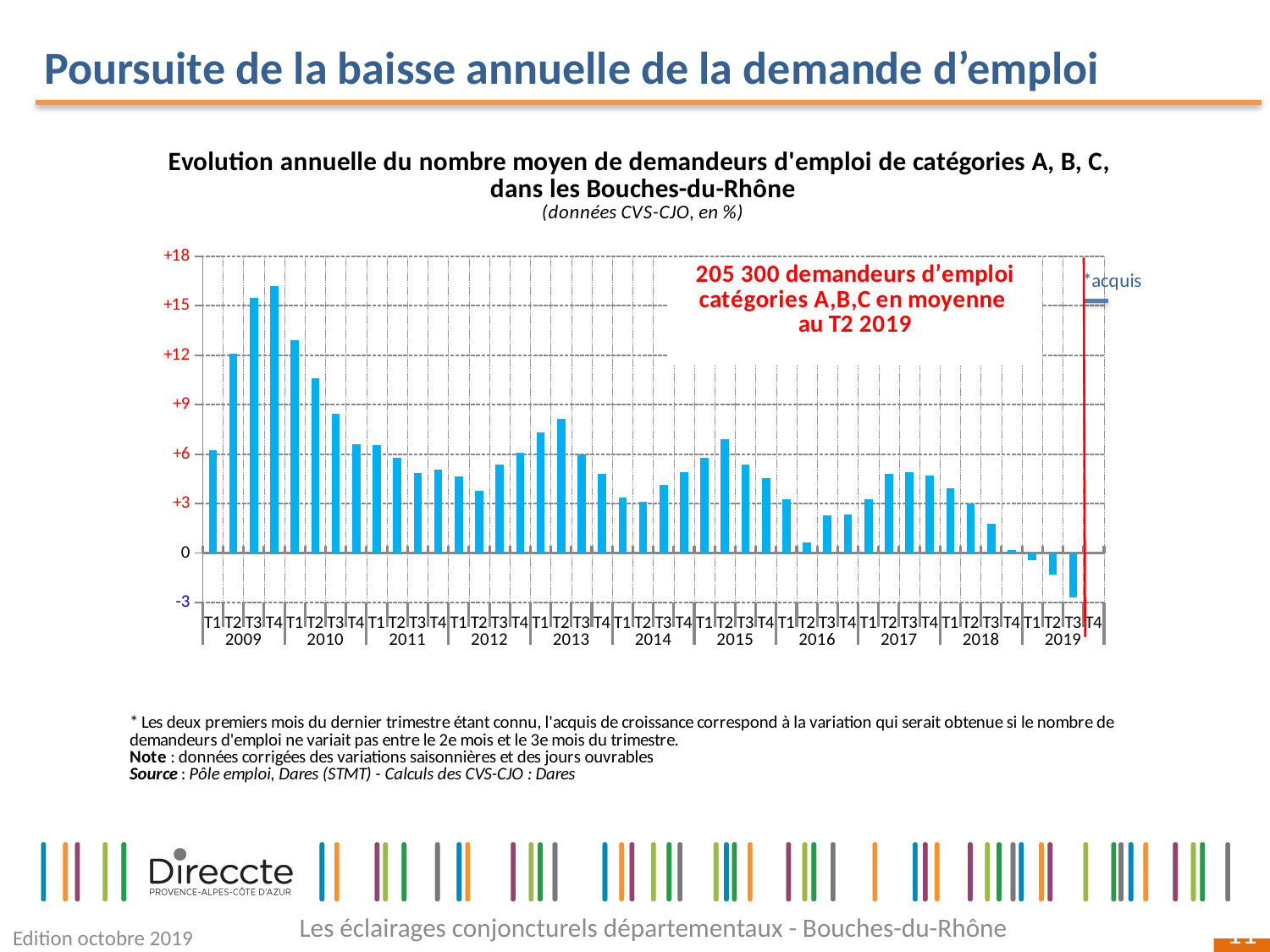
What kind of chart is shown on the slide? bar chart Do the values rise or fall from T4 2009 to T3 2010? fall Is the value for T3 2010 greater or less than +9? less How many years are labelled on the x axis of the chart? 11 Is the value for T1 2013 greater or less than +6? greater Is the value for T3 2019 greater or less than 0? less Which quarter has the lowest value in the chart? T3 2019 Which quarter has the highest value in the chart? T4 2009 Which is larger, the value for T2 2015 or the value for T2 2016? T2 2015 According to the annotation on the chart, how many demandeurs d'emploi of categories A, B, C were there on average in T2 2019? 205 300